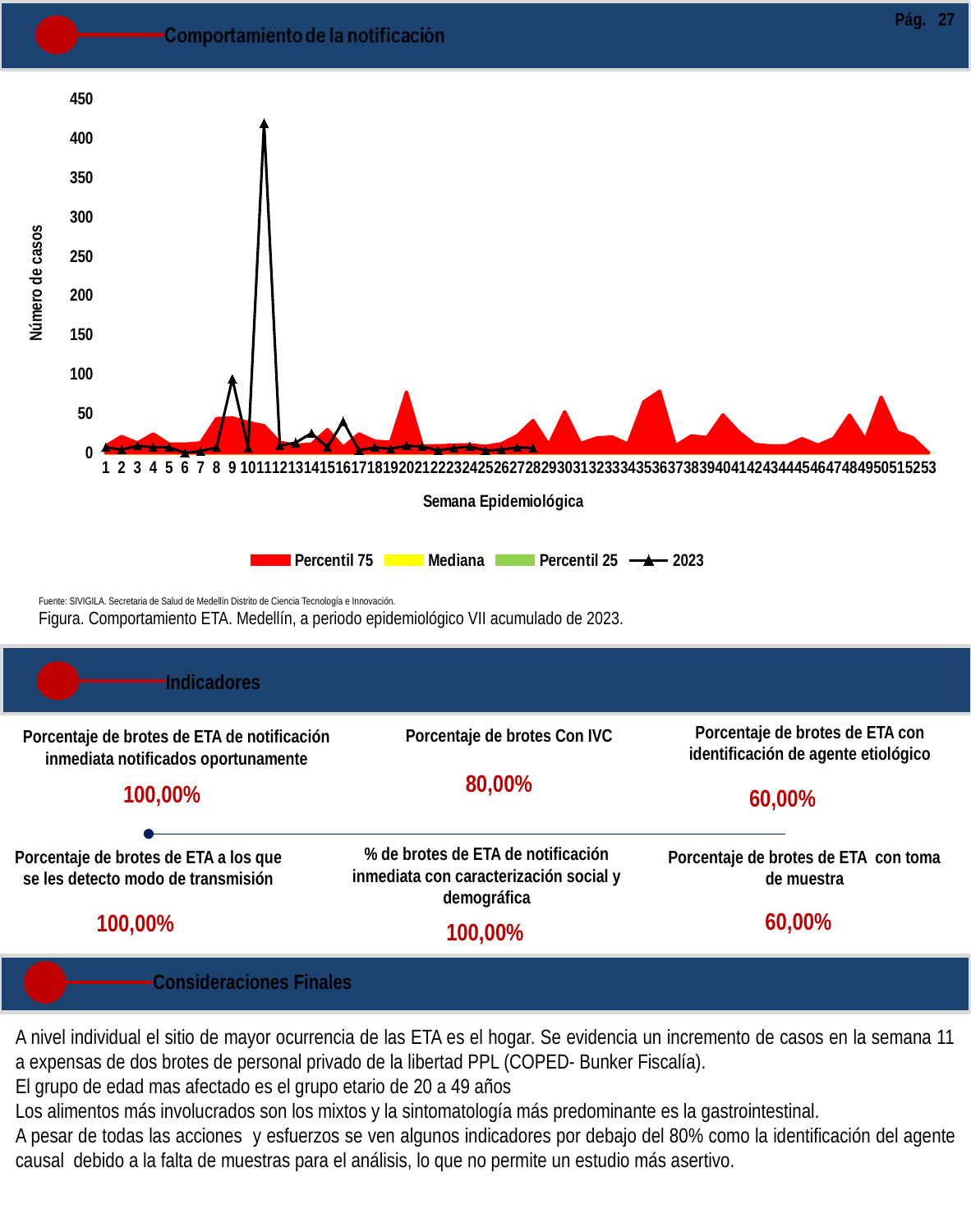
Is the value of the 2023 series in week 11 greater or less than 400? greater How many epidemiological weeks are shown on the x axis of the chart? 53 In which epidemiological week does the 2023 series reach its highest value? 11 Is the value of the 2023 series in week 1 greater or less than 50? less Is the Percentil 75 value in week 36 greater or less than 50? greater How many series does the chart legend list? 4 What is the highest tick value shown on the y axis of the chart? 450 What kind of chart is used to plot the 2023 series? line chart Does the 2023 line rise or fall from week 11 to week 12? fall Which is larger for the 2023 series: the value in week 11 or the value in week 9? week 11 What is the title of the x axis of the chart? Semana Epidemiológica